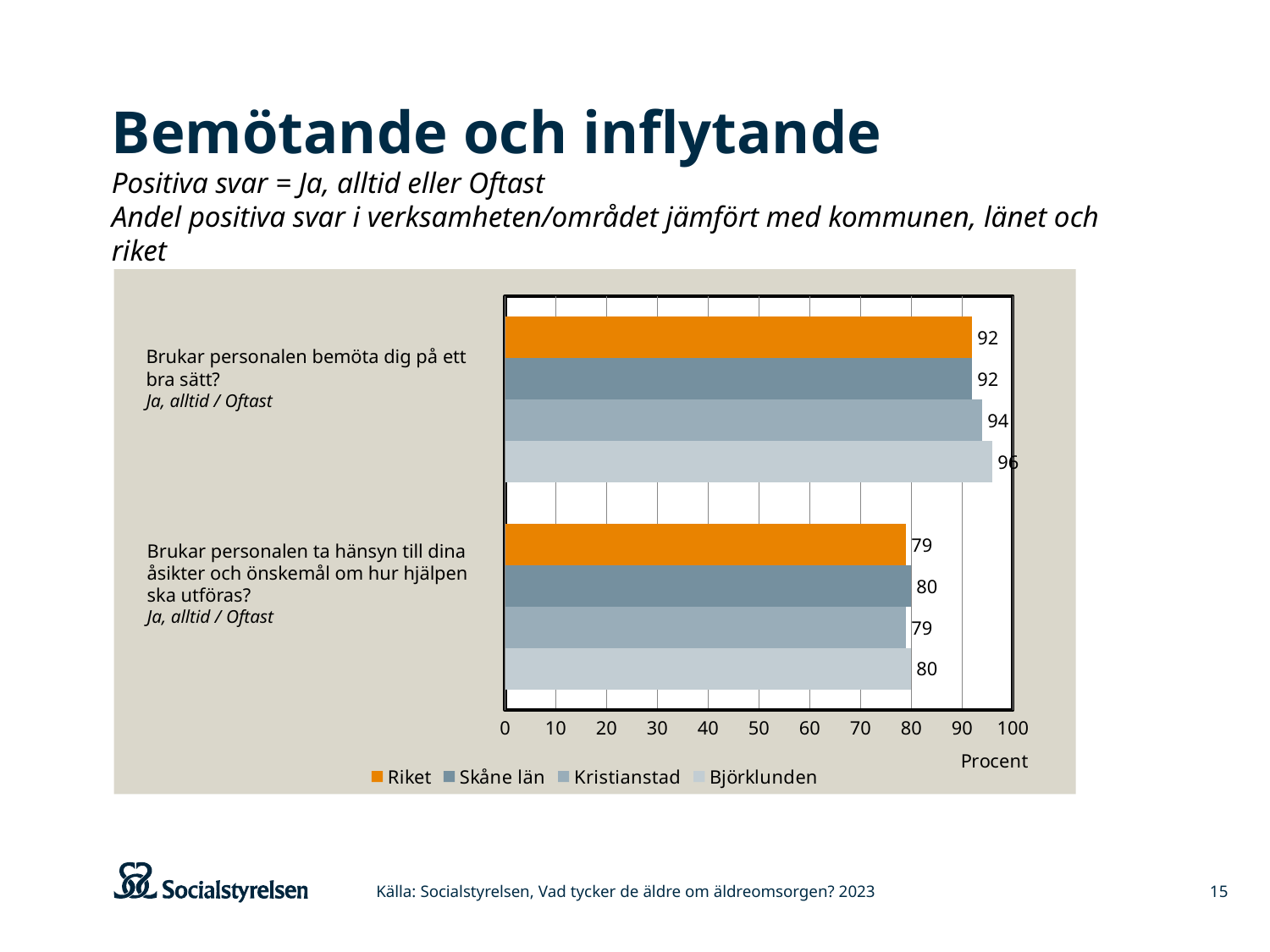
What unit label is shown on the x axis of the chart? Procent What kind of chart is shown on the slide? bar chart What is the value for Riket for "Brukar personalen ta hänsyn till dina åsikter och önskemål om hur hjälpen ska utföras?" 79 Which series has the highest value for "Brukar personalen bemöta dig på ett bra sätt?" Björklunden How many series does the legend list? 4 What is the difference between the Björklunden and Riket values for "Brukar personalen bemöta dig på ett bra sätt?" 4 Is the value for Riket for "Brukar personalen ta hänsyn till dina åsikter och önskemål om hur hjälpen ska utföras?" greater or less than 80? less What is the value for Kristianstad for "Brukar personalen bemöta dig på ett bra sätt?" 94 Which is larger for "Brukar personalen bemöta dig på ett bra sätt?": the value for Kristianstad or the value for Skåne län? Kristianstad How many question categories are plotted on the chart? 2 What is the value for Skåne län for "Brukar personalen ta hänsyn till dina åsikter och önskemål om hur hjälpen ska utföras?" 80 What is the value for Björklunden for "Brukar personalen bemöta dig på ett bra sätt?" 96